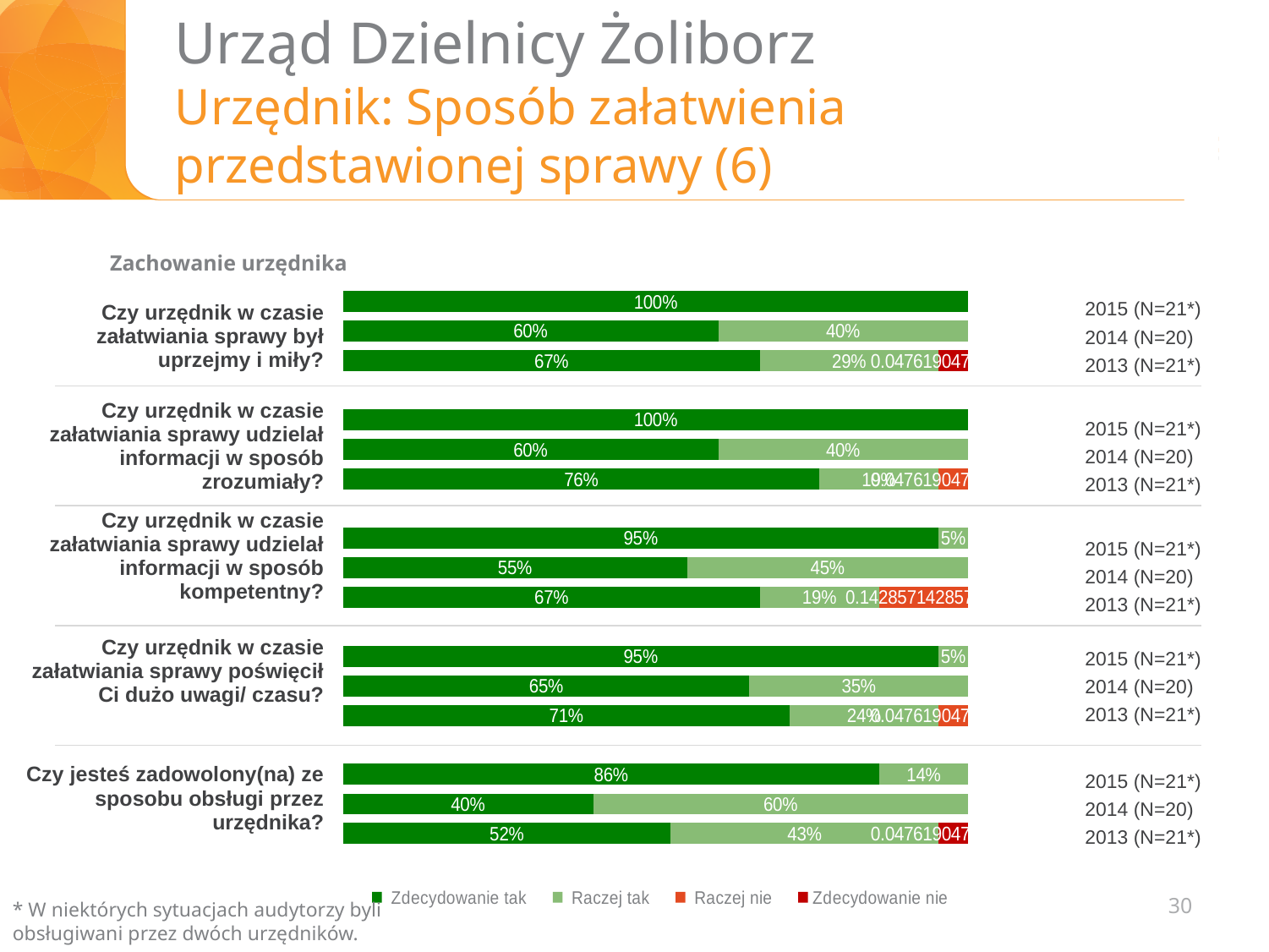
For the question 'Czy urzędnik w czasie załatwiania sprawy udzielał informacji w sposób kompetentny?', which is larger: the 'Zdecydowanie tak' value for 2013 (N=21*) or for 2014 (N=20)? 2013 (N=21*) For the question 'Czy jesteś zadowolony(na) ze sposobu obsługi przez urzędnika?', which year has the lowest 'Zdecydowanie tak' value? 2014 (N=20) What type of chart is shown on the slide? stacked bar chart What is the 'Zdecydowanie tak' value for 2014 (N=20) for the question 'Czy urzędnik w czasie załatwiania sprawy udzielał informacji w sposób kompetentny?'? 55% What is the 'Raczej tak' value for 2014 (N=20) for the question 'Czy jesteś zadowolony(na) ze sposobu obsługi przez urzędnika?'? 60% For the question 'Czy urzędnik w czasie załatwiania sprawy poświęcił Ci dużo uwagi/ czasu?', what is the difference between the 'Zdecydowanie tak' values for 2015 (N=21*) and 2014 (N=20)? 30% How many survey questions are shown in the chart? 5 How many series does the legend list? 4 What is the title shown above the chart? Zachowanie urzędnika What is the 'Zdecydowanie tak' value for 2013 (N=21*) for the question 'Czy urzędnik w czasie załatwiania sprawy udzielał informacji w sposób zrozumiały?'? 76% What is the 'Zdecydowanie tak' value for 2015 (N=21*) for the question 'Czy urzędnik w czasie załatwiania sprawy był uprzejmy i miły?'? 100% For the question 'Czy urzędnik w czasie załatwiania sprawy poświęcił Ci dużo uwagi/ czasu?', what is the 'Raczej tak' value for 2013 (N=21*)? 24%